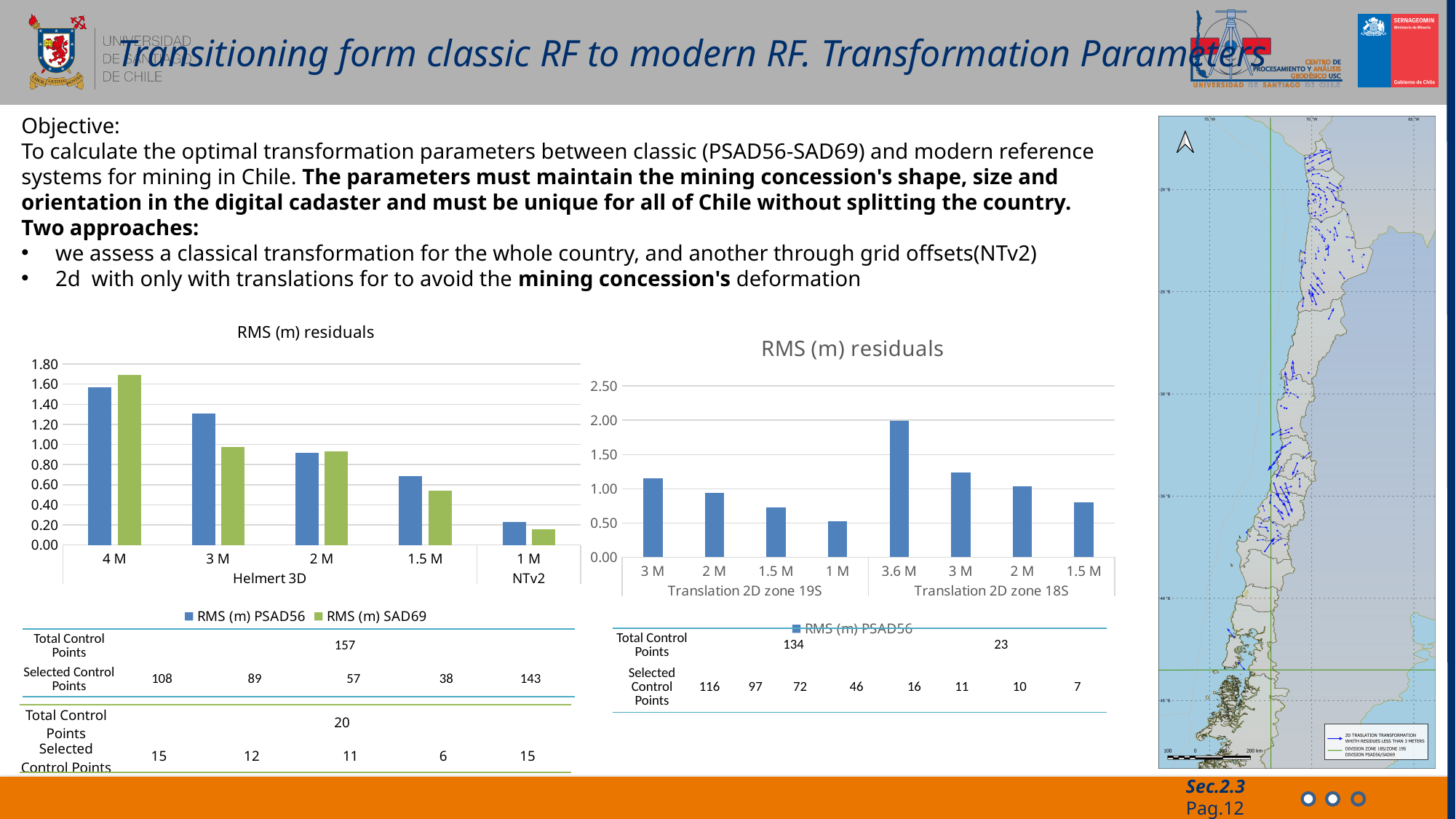
In the right chart, is the value for 3.6 M under Translation 2D zone 18S greater or less than 1.50? greater What type of chart is the left chart titled 'RMS (m) residuals'? bar chart In the left chart, is the RMS (m) PSAD56 value for 4 M greater or less than 1.40? greater How many series does the legend of the left chart list? 2 How many bars are plotted in the right chart titled 'RMS (m) residuals'? 8 In the right chart, which category has the highest RMS (m) PSAD56 value? 3.6 M (Translation 2D zone 18S) In the left chart, which series has the highest bar overall? RMS (m) SAD69 In the right chart, do the values rise or fall from 3 M to 1 M within Translation 2D zone 19S? fall In the right chart, is the value for 1 M under Translation 2D zone 19S greater or less than 1.00? less In the left chart, which category group is labelled NTv2? 1 M In the right chart, which category has the lowest RMS (m) PSAD56 value? 1 M (Translation 2D zone 19S) In the left chart, which is larger at 3 M: RMS (m) PSAD56 or RMS (m) SAD69? RMS (m) PSAD56